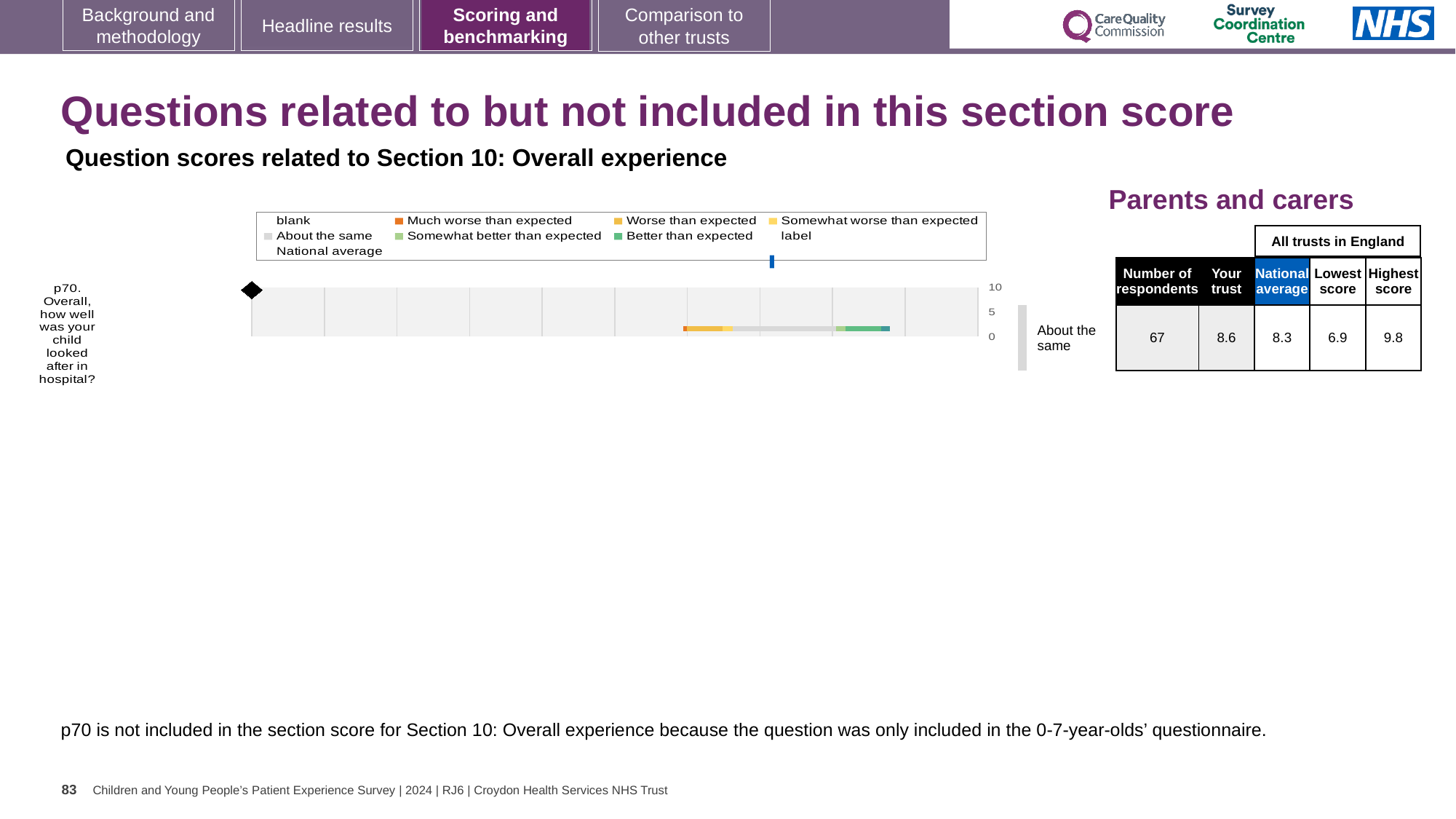
In the table next to the chart, what is the lowest score among all trusts in England for p70? 6.9 In the table next to the chart, what is the national average score for p70? 8.3 How many questions (categories) are plotted in the chart? 1 In the table next to the chart, what is the 'Your trust' score for p70? 8.6 In the table next to the chart, what is the highest score among all trusts in England for p70? 9.8 How many respondents answered p70 according to the table next to the chart? 67 What is the difference between the highest score and the lowest score for p70 in the table next to the chart? 2.9 What is the highest tick value shown on the chart's axis? 10 What benchmark label is shown to the right of the p70 bar? About the same Which question is plotted in the chart? p70. Overall, how well was your child looked after in hospital? Which is larger for p70: the 'Your trust' score or the national average? Your trust What kind of chart is shown for question p70? bar chart